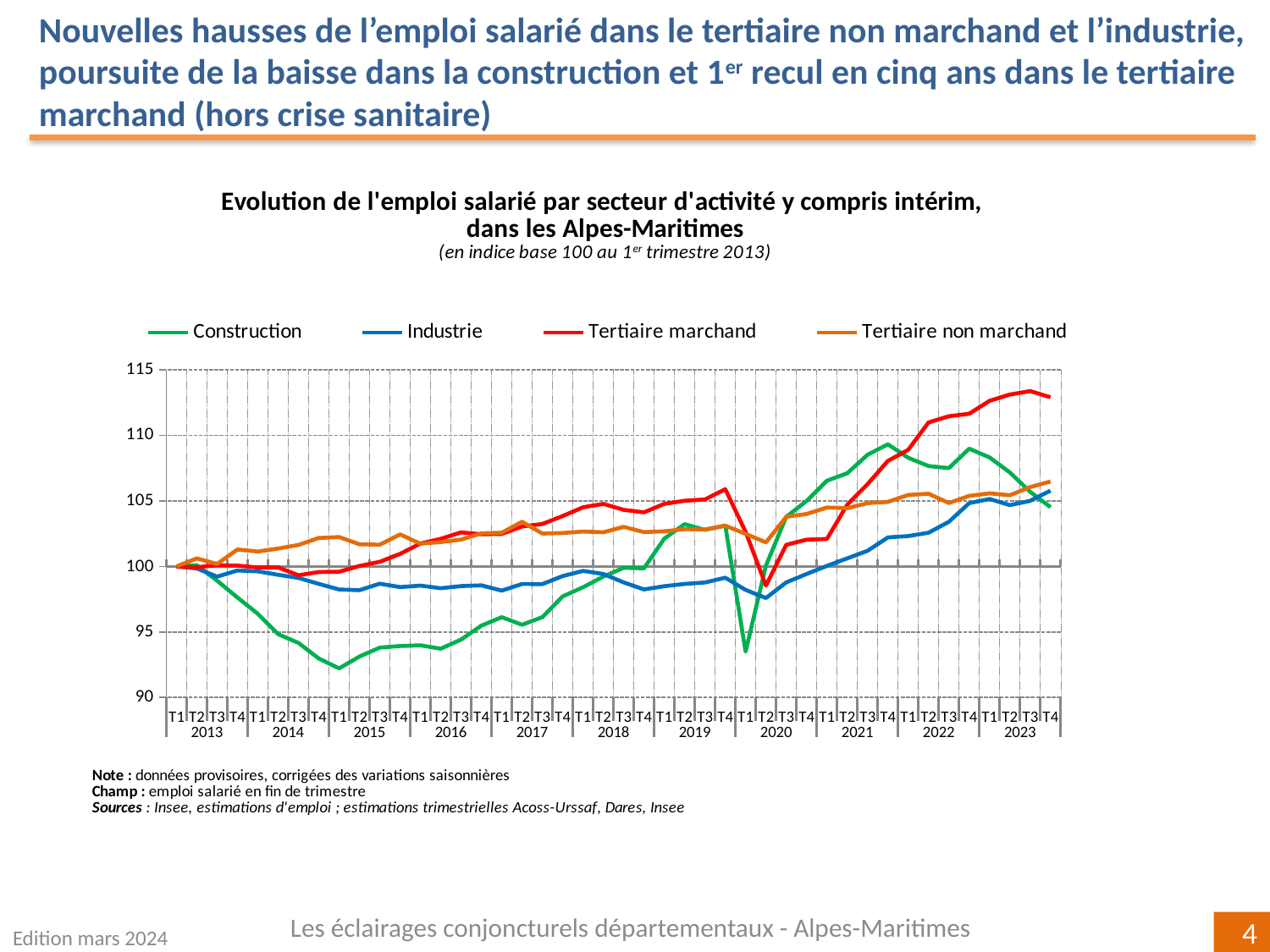
What kind of chart is shown on the slide? line chart Is the value for Industrie at T1 2015 greater or less than 100? less Is the value for Construction at T1 2020 greater or less than 95? less Is the value for Tertiaire marchand at T4 2023 greater or less than 110? greater How many series does the legend list? 4 Does the Construction series rise or fall between T1 2013 and T1 2015? fall At T1 2020, which is larger: Tertiaire marchand or Construction? Tertiaire marchand How many years are labelled on the x axis? 11 Which series has the highest value at T4 2023? Tertiaire marchand Which series are listed in the legend? Construction, Industrie, Tertiaire marchand, Tertiaire non marchand Which series has the lowest value at T1 2020? Construction What is the index value of every series at T1 2013? 100